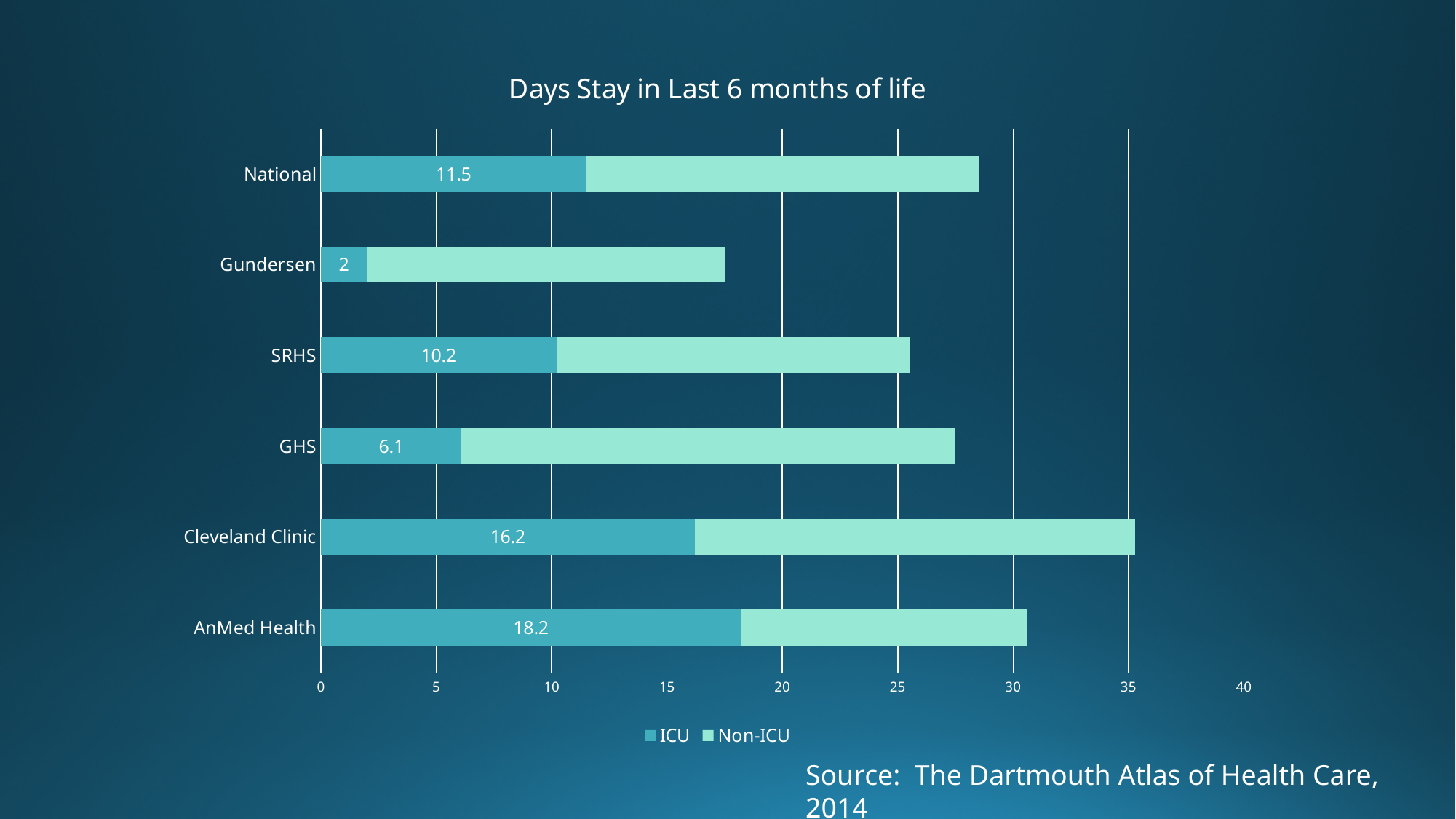
How many categories are shown on the chart? 6 Which has a larger ICU value, SRHS or GHS? SRHS Is the total bar length for Gundersen greater or less than 20? less What is the difference between the ICU values for AnMed Health and Cleveland Clinic? 2 What kind of chart is shown on the slide? Stacked bar chart Which category has the lowest ICU value? Gundersen What is the ICU value for AnMed Health? 18.2 Which category has the highest ICU value? AnMed Health Is the total bar length for National greater or less than 25? greater How many series does the legend list? 2 What is the ICU value for National? 11.5 What is the ICU value for Gundersen? 2